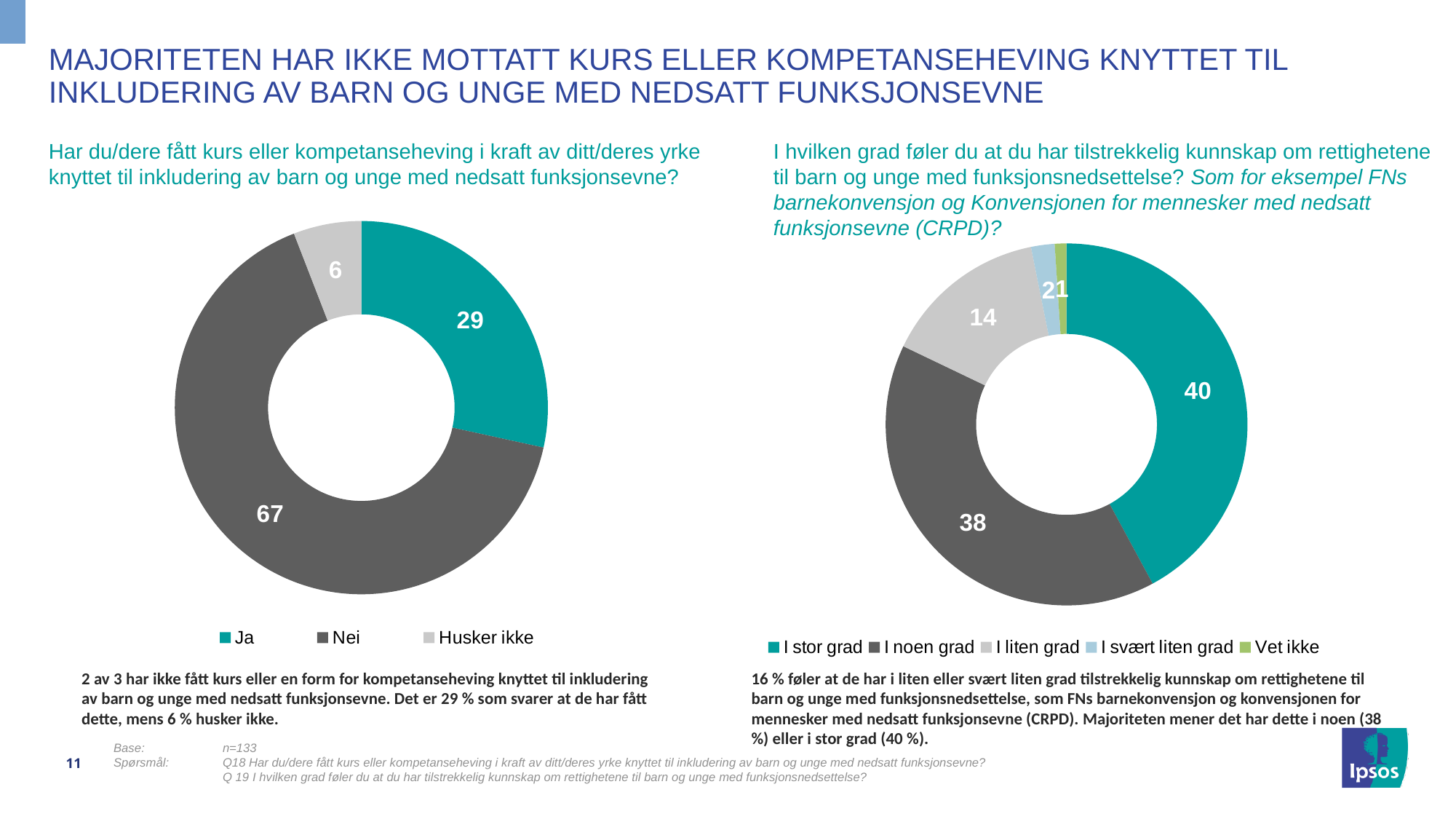
How many categories does the legend of the right chart list? 5 How many categories does the legend of the left chart list? 3 In the left chart, what is the difference between the values for "Nei" and "Ja"? 38 In the left chart, which category has the smallest share? Husker ikke In the left chart, which category has the largest share? Nei In the right chart, what is the value for "I noen grad"? 38 In the left chart, what is the value for "Ja"? 29 In the right chart, what is the value for "I liten grad"? 14 What type of chart is used on the right side of the slide? Doughnut (pie) chart In the left chart, what is the value for "Nei"? 67 In the left chart, what is the value for "Husker ikke"? 6 In the right chart, what is the value for "I stor grad"? 40